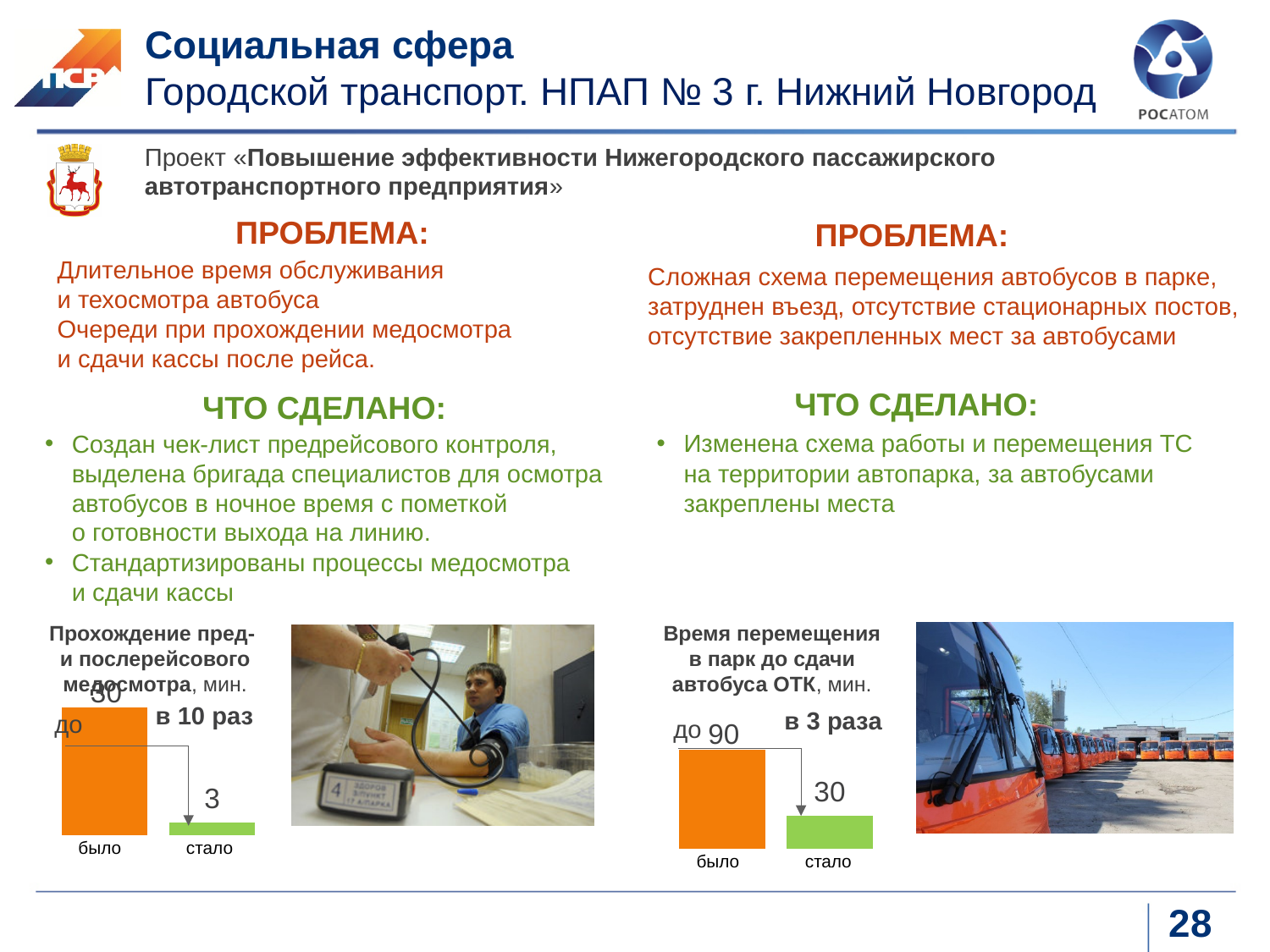
In the left chart (Прохождение пред- и послерейсового медосмотра), what is the difference between «было» and «стало»? 27 In the left chart (Прохождение пред- и послерейсового медосмотра), by what factor does the annotation say the value decreased? в 10 раз In the left chart (Прохождение пред- и послерейсового медосмотра), what value is shown for «было»? до 30 In the right chart (Время перемещения в парк до сдачи автобуса ОТК), what unit is stated in the chart title? мин. In the left chart (Прохождение пред- и послерейсового медосмотра), which category has the lowest value? стало What type of chart is the right chart (Время перемещения в парк до сдачи автобуса ОТК)? bar chart In the right chart (Время перемещения в парк до сдачи автобуса ОТК), what value is shown for «было»? до 90 In the right chart (Время перемещения в парк до сдачи автобуса ОТК), what is the difference between «было» and «стало»? 60 How many categories does the left chart (Прохождение пред- и послерейсового медосмотра) show? 2 In the right chart (Время перемещения в парк до сдачи автобуса ОТК), what value is shown for «стало»? 30 In the left chart (Прохождение пред- и послерейсового медосмотра), what value is shown for «стало»? 3 In the right chart (Время перемещения в парк до сдачи автобуса ОТК), which category has the higher value, «было» or «стало»? было